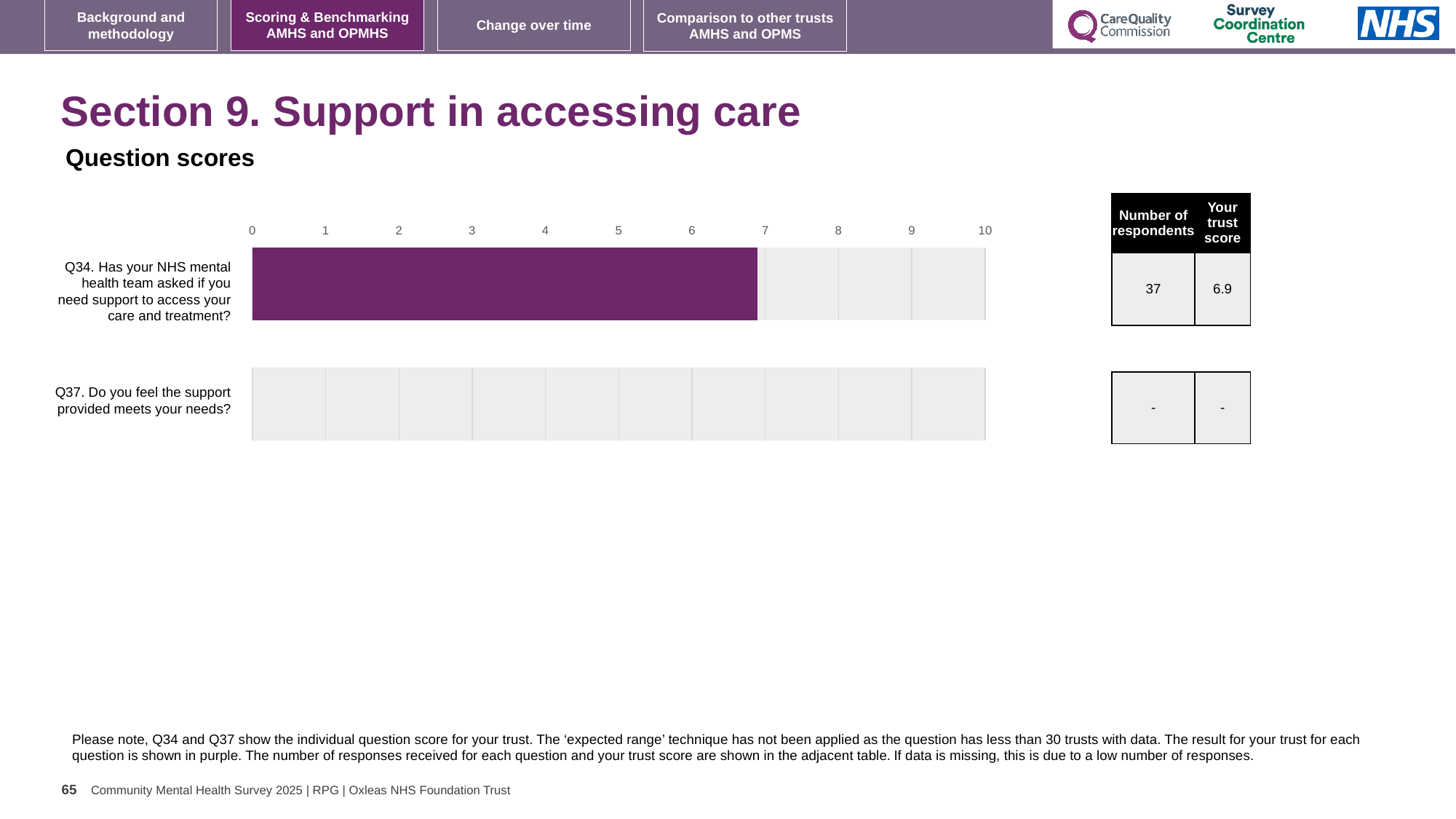
Which question has the highest score shown on the chart? Q34 What is the trust score shown for Q37 (Do you feel the support provided meets your needs?)? - What colour is the bar showing the trust's result for Q34? purple How many respondents answered Q34? 37 What is the trust score for Q34 (Has your NHS mental health team asked if you need support to access your care and treatment?)? 6.9 What kind of chart is shown on the slide? bar chart What is the maximum value shown on the chart's x axis? 10 How many questions (categories) are listed on the chart? 2 Is the value for Q34 greater or less than 5? greater Is the value for Q34 greater or less than 7? less